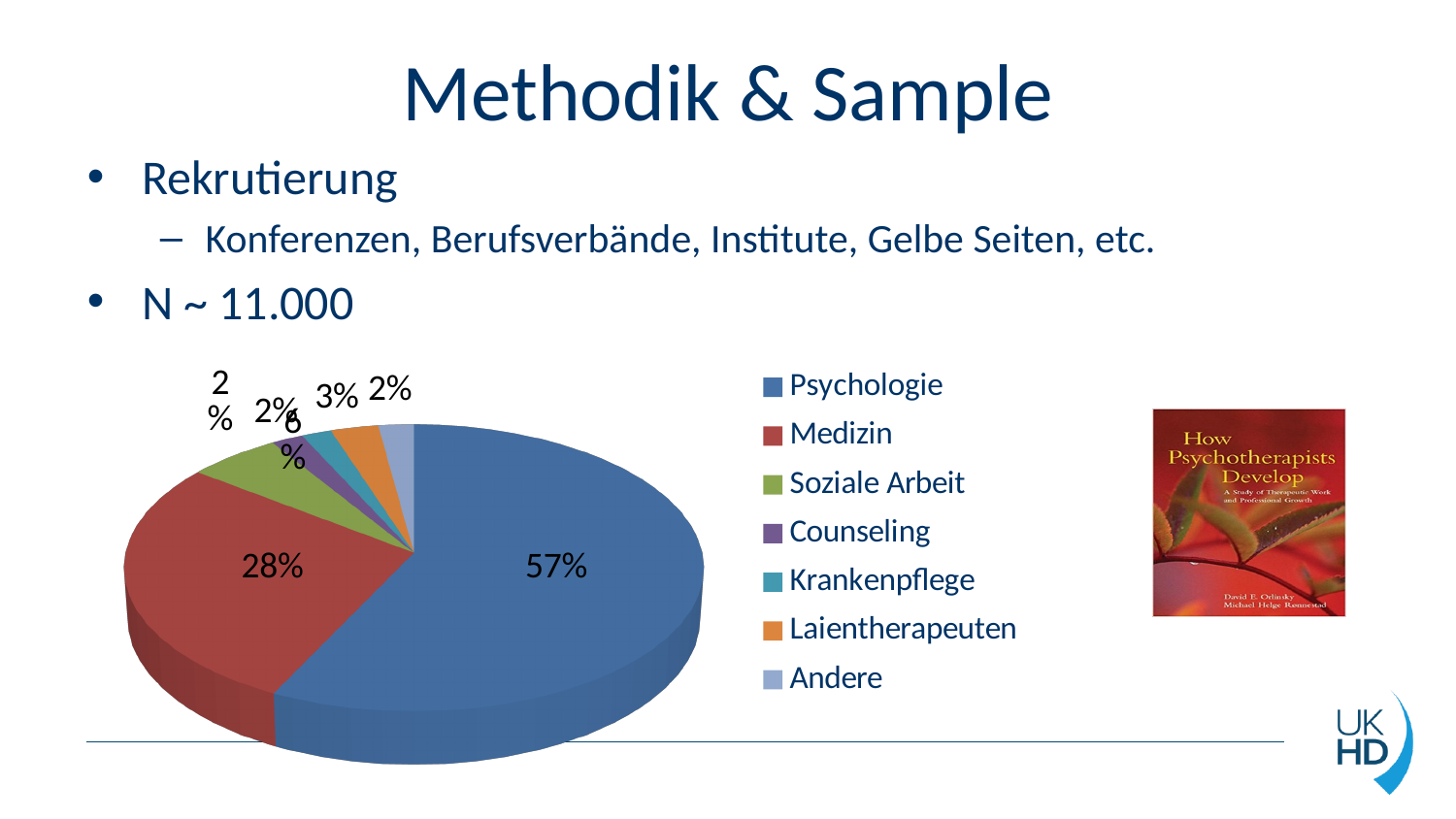
Which category is listed last in the legend of the pie chart? Andere What share of the pie does Psychologie have? 57% Which is larger, the slice for Medizin or the slice for Soziale Arbeit? Medizin Which category is shown in red in the pie chart? Medizin What kind of chart is shown on the slide? pie chart Is the share for Psychologie greater or less than 50%? greater What share of the pie does Medizin have? 28% Which is larger, the slice for Psychologie or the slice for Medizin? Psychologie What is the difference in percentage points between the Psychologie slice and the Medizin slice? 29 Which category has the largest slice of the pie? Psychologie How many categories does the legend of the pie chart list? 7